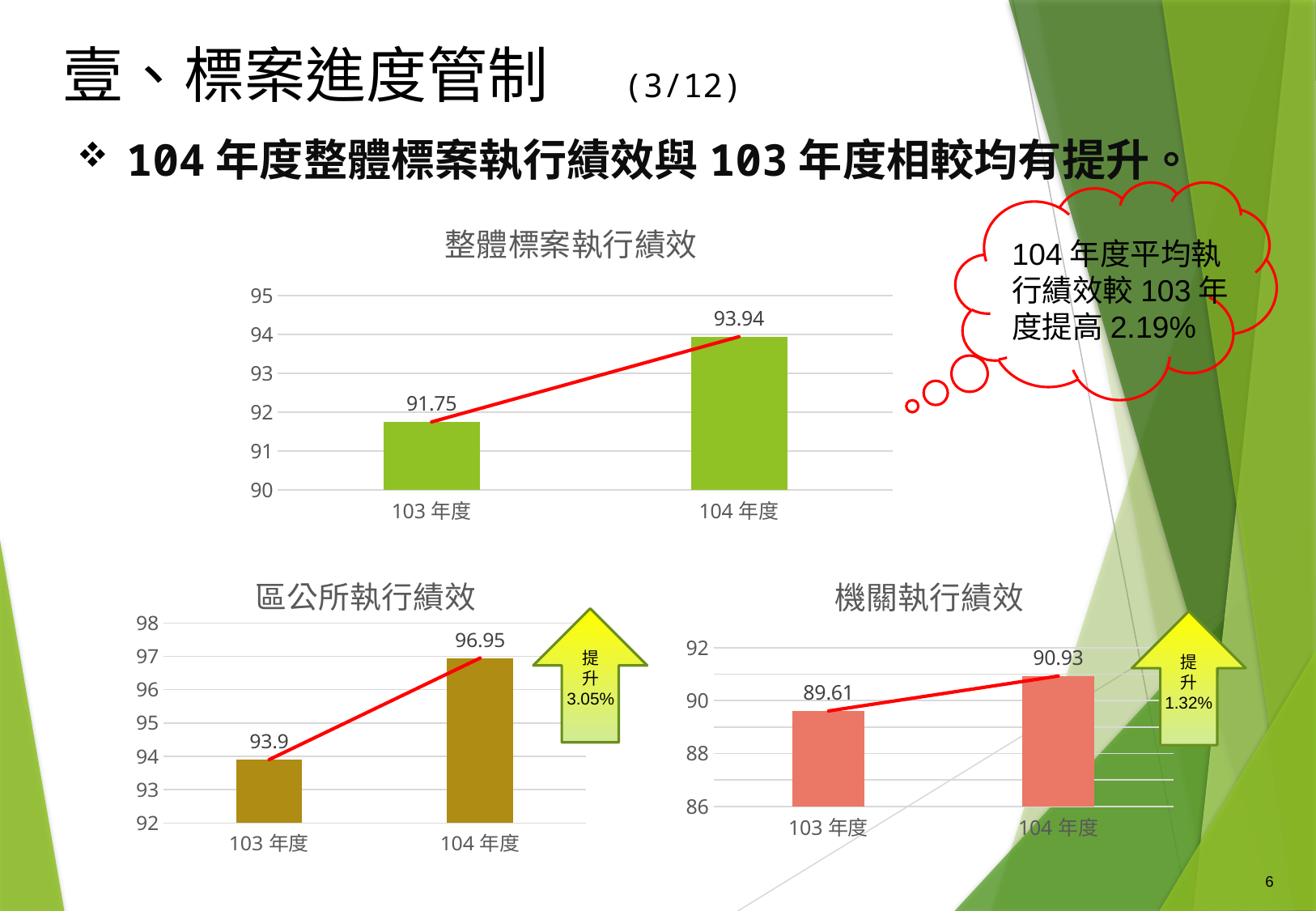
In the 區公所執行績效 chart, by how much does the 104 年度 value exceed the 103 年度 value? 3.05 How many charts are shown on the slide? 3 In the 機關執行績效 chart, what is the value for 104 年度? 90.93 In the 整體標案執行績效 chart, what is the difference between the 104 年度 and 103 年度 values? 2.19 In the 區公所執行績效 chart, which year has the higher value? 104 年度 In the 機關執行績效 chart, what is the value for 103 年度? 89.61 In the 機關執行績效 chart, which year has the lower value? 103 年度 In the 整體標案執行績效 chart, what is the value for 103 年度? 91.75 In the 區公所執行績效 chart, what is the value for 103 年度? 93.9 In the 區公所執行績效 chart, what is the value for 104 年度? 96.95 In the 整體標案執行績效 chart, what is the value for 104 年度? 93.94 What type of chart is the 整體標案執行績效 chart? Bar chart